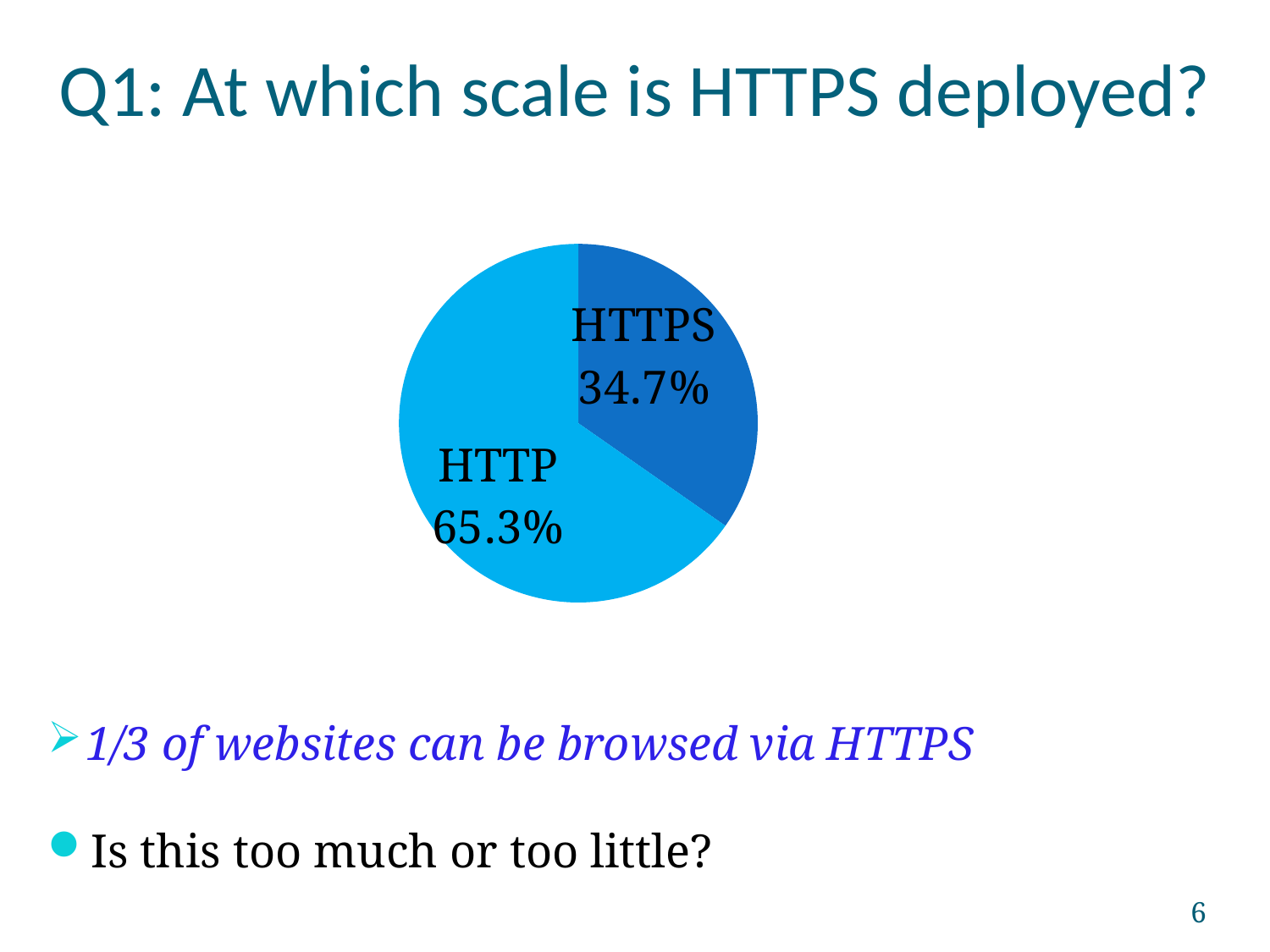
What percentage of the pie is labelled HTTP? 65.3% What is the difference in percentage points between the HTTP and HTTPS slices? 30.6 How many slices does the pie chart have? 2 Which slice of the pie is drawn in the darker blue colour? HTTPS Is the HTTPS share greater or less than 50%? less Which is larger, the HTTP slice or the HTTPS slice? HTTP What is the title of the slide containing the pie chart? Q1: At which scale is HTTPS deployed? What kind of chart is shown on the slide? pie chart Which slice of the pie is the largest? HTTP What percentage of the pie is labelled HTTPS? 34.7% What share of the pie does the HTTPS slice represent? 34.7% Which slice of the pie is the smallest? HTTPS